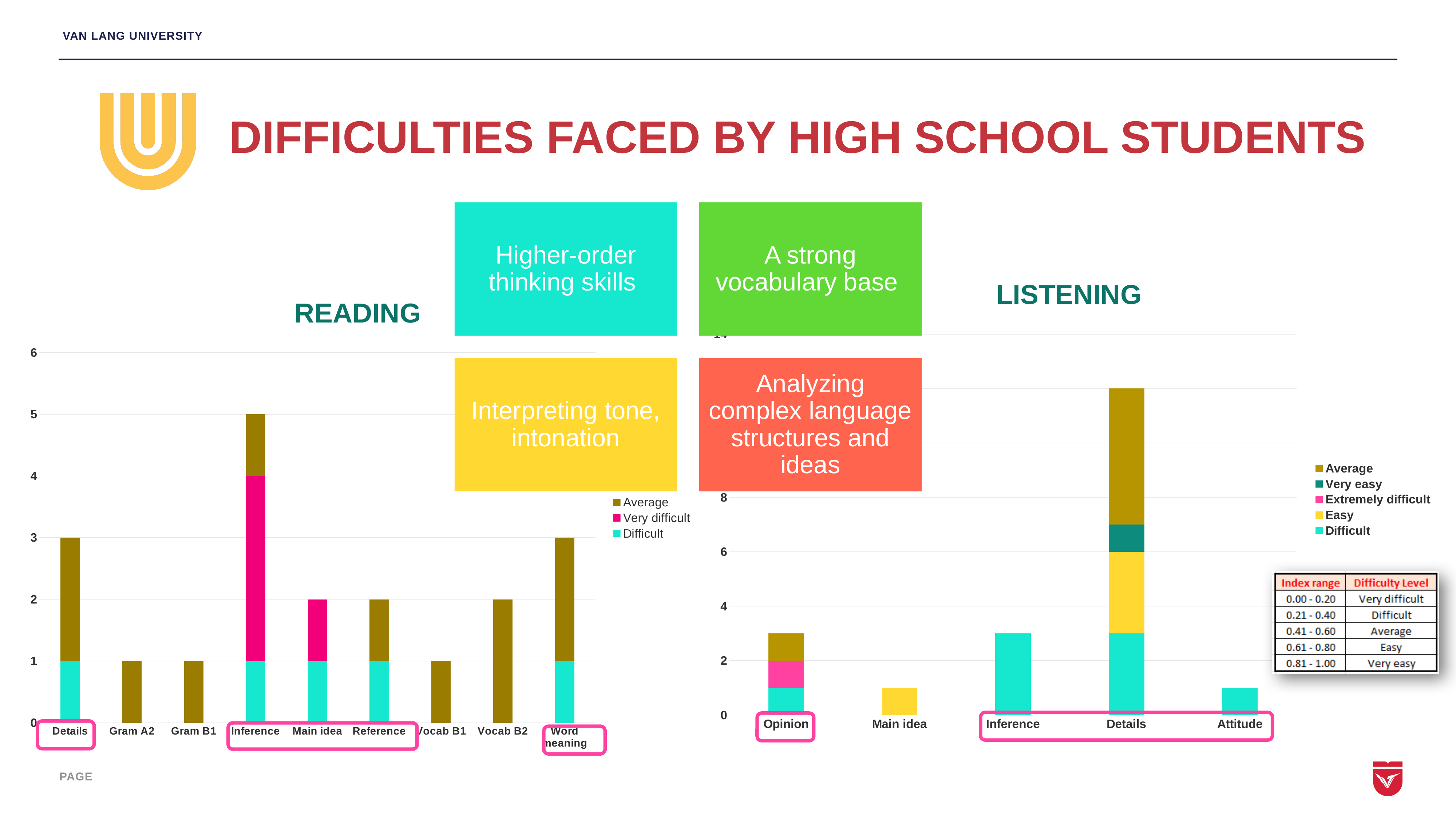
In the READING chart, which category has the tallest bar? Inference What kind of chart is the READING chart? Stacked bar chart In the READING chart, how many categories are shown on the x axis? 9 In the LISTENING chart, how many categories are shown on the x axis? 5 In the LISTENING chart, how many series does the legend list? 5 In the READING chart, what is the total height of the Inference bar? 5 In the READING chart, what is the total height of the Details bar? 3 In the LISTENING chart, is the total value for Main idea greater or less than 2? less In the LISTENING chart, is the total value for Details greater or less than 10? greater In the READING chart, is the Word meaning bar taller or shorter than the Reference bar? Taller In the LISTENING chart, which category has the tallest bar? Details In the READING chart, how many series does the legend list? 3